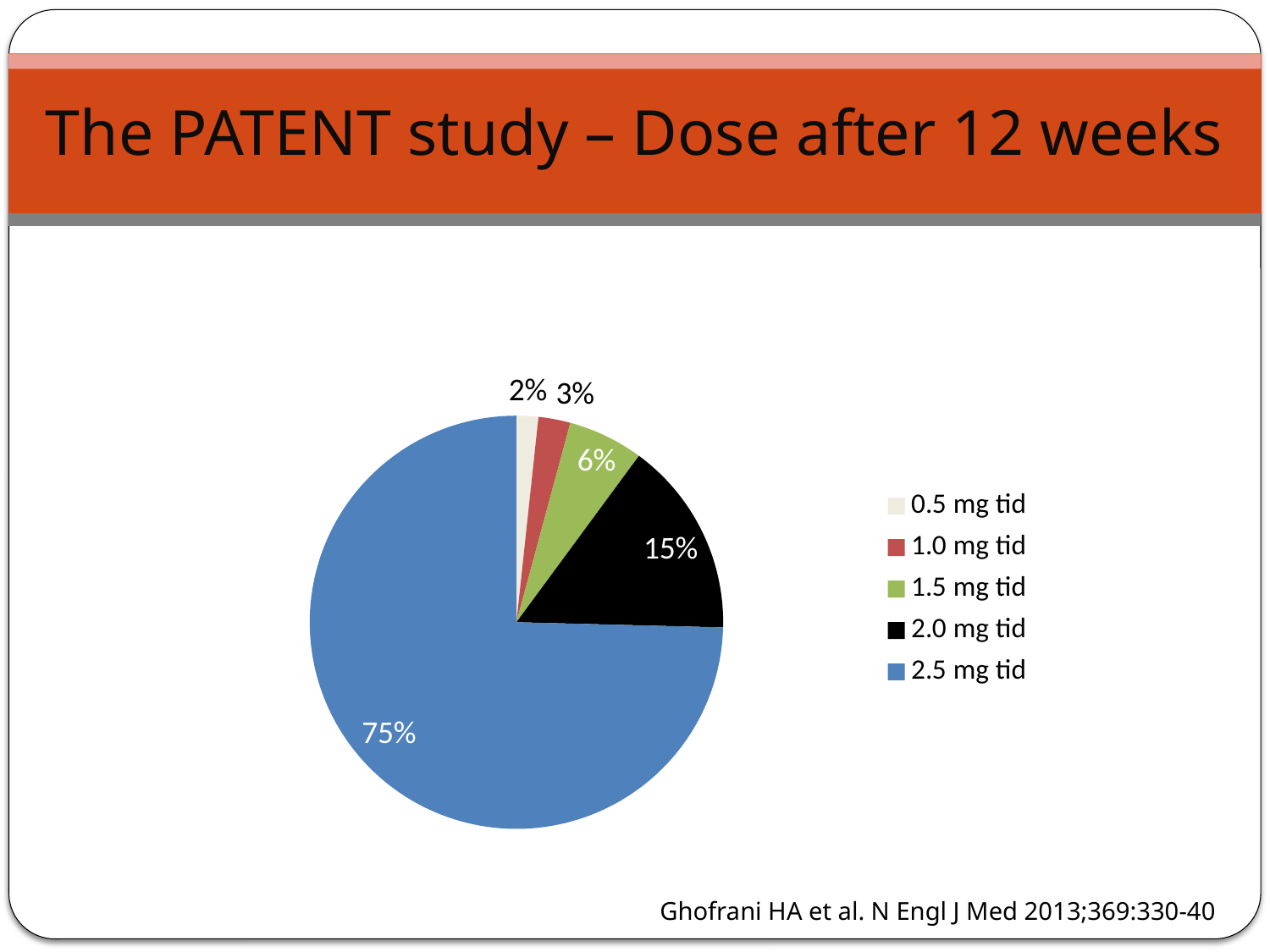
How many dose categories does the legend list? 5 What is the value shown for the 0.5 mg tid slice? 2% Which dose has the smallest slice of the pie? 0.5 mg tid What is the value shown for the 1.5 mg tid slice? 6% What colour is the 2.0 mg tid slice? black What is the difference between the 2.5 mg tid and 2.0 mg tid shares? 60% What kind of chart is shown on the slide? pie chart What share of the pie does the 2.5 mg tid dose have? 75% Which dose has the largest slice of the pie? 2.5 mg tid What is the value shown for the 1.0 mg tid slice? 3% Which is larger, the 1.5 mg tid slice or the 1.0 mg tid slice? 1.5 mg tid What is the value shown for the 2.0 mg tid slice? 15%